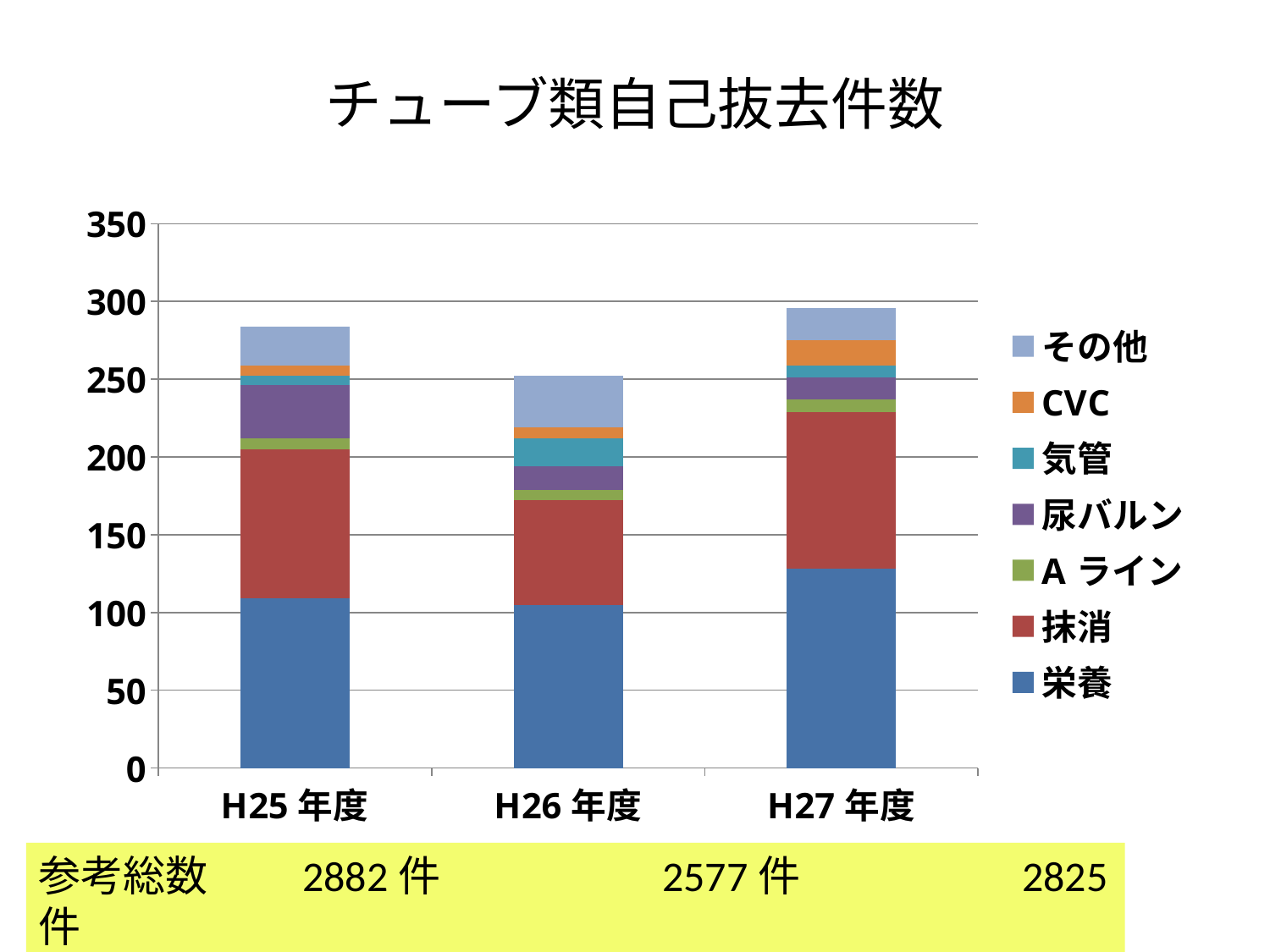
What kind of chart is shown on the slide? stacked bar chart Which is larger, the 栄養 value for H25 年度 or for H27 年度? H27 年度 Is the total for H27 年度 greater or less than 250? greater How many series does the legend list? 7 Is the total for H26 年度 greater or less than 300? less Is the 栄養 value for H27 年度 greater or less than 100? greater Which fiscal year has the highest total stacked bar? H27 年度 Does the total stacked bar rise or fall from H26 年度 to H27 年度? rise How many categories (fiscal years) are shown on the x axis? 3 Which fiscal year has the lowest total stacked bar? H26 年度 What is the title of the chart? チューブ類自己抜去件数